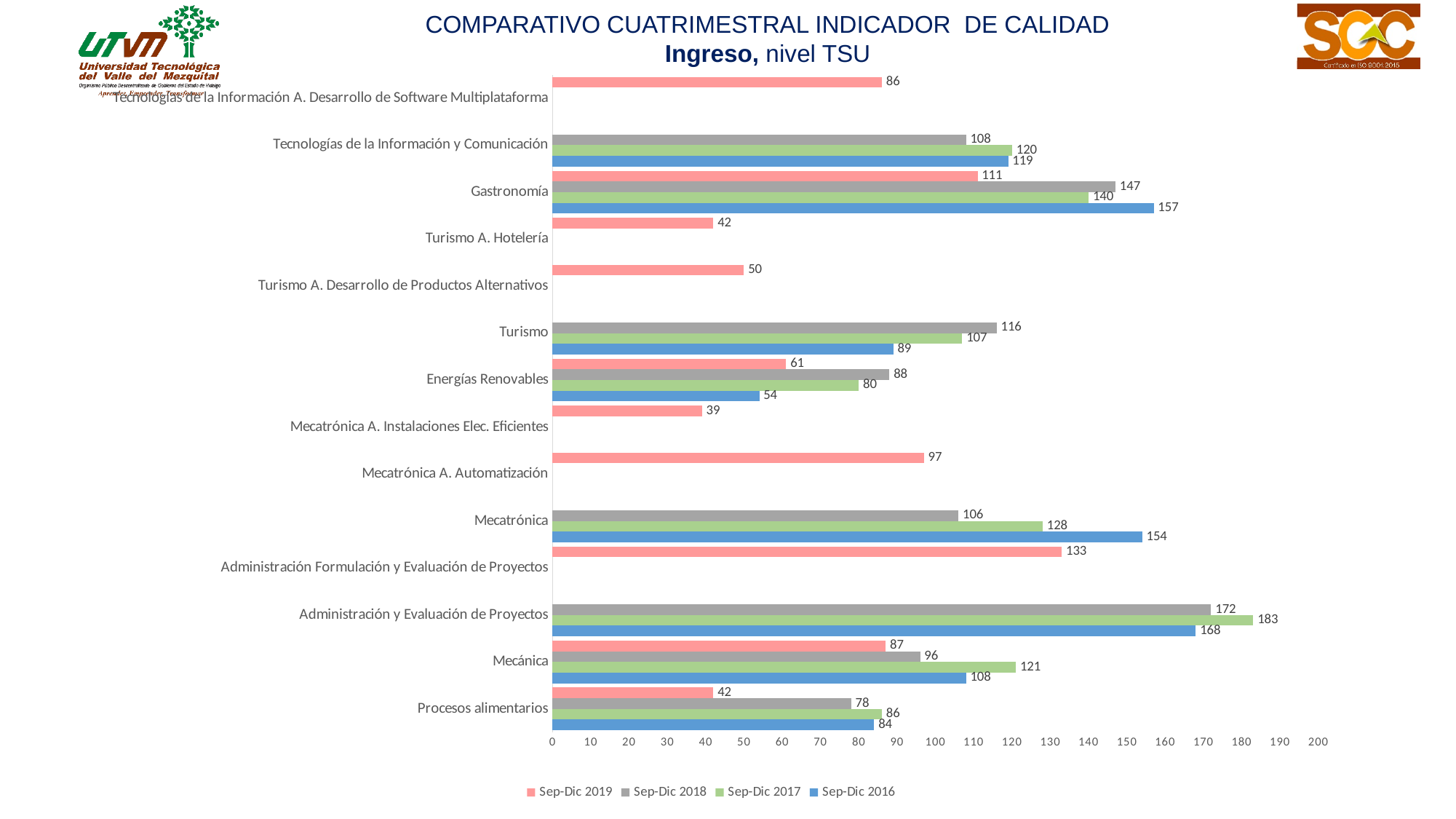
What is the difference between the Sep-Dic 2017 and Sep-Dic 2018 values for Mecánica? 25 Which series is shown in pink in the legend? Sep-Dic 2019 What is the Sep-Dic 2018 value for Energías Renovables? 88 Which category has the highest Sep-Dic 2019 value? Administración Formulación y Evaluación de Proyectos What is the Sep-Dic 2017 value for Administración y Evaluación de Proyectos? 183 How many series does the legend list? 4 What is the Sep-Dic 2016 value for Gastronomía? 157 What kind of chart is shown on the slide? Bar chart Which category has the lowest Sep-Dic 2019 value? Mecatrónica A. Instalaciones Elec. Eficientes How many categories are shown on the vertical axis? 14 For Turismo, which is larger: the Sep-Dic 2018 value or the Sep-Dic 2016 value? Sep-Dic 2018 What is the Sep-Dic 2019 value for Mecatrónica A. Automatización? 97